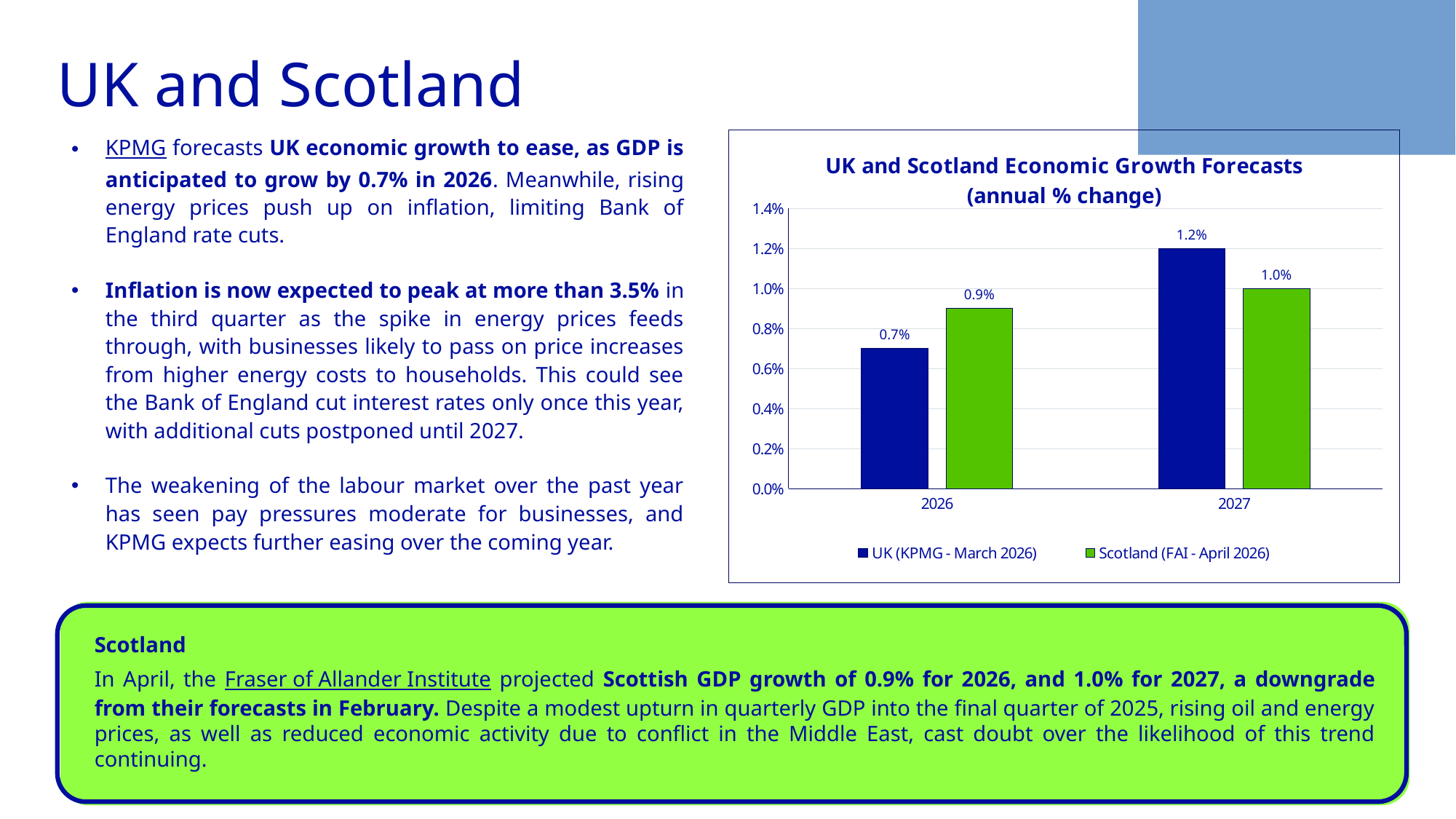
What is the UK (KPMG - March 2026) forecast value for 2026? 0.7% What is the Scotland (FAI - April 2026) forecast value for 2027? 1.0% What is the UK (KPMG - March 2026) forecast value for 2027? 1.2% What kind of chart is shown on the slide? Bar chart How many years are shown on the x axis of the chart? 2 Does the UK (KPMG - March 2026) forecast rise or fall from 2026 to 2027? Rise In 2026, which is larger: the UK forecast or the Scotland forecast? Scotland (FAI - April 2026) What is the difference between the UK and Scotland forecast values for 2027? 0.2% Which series has the lowest value in 2026? UK (KPMG - March 2026) Which year has the highest UK (KPMG - March 2026) forecast value? 2027 How many series does the chart legend list? 2 What is the Scotland (FAI - April 2026) forecast value for 2026? 0.9%